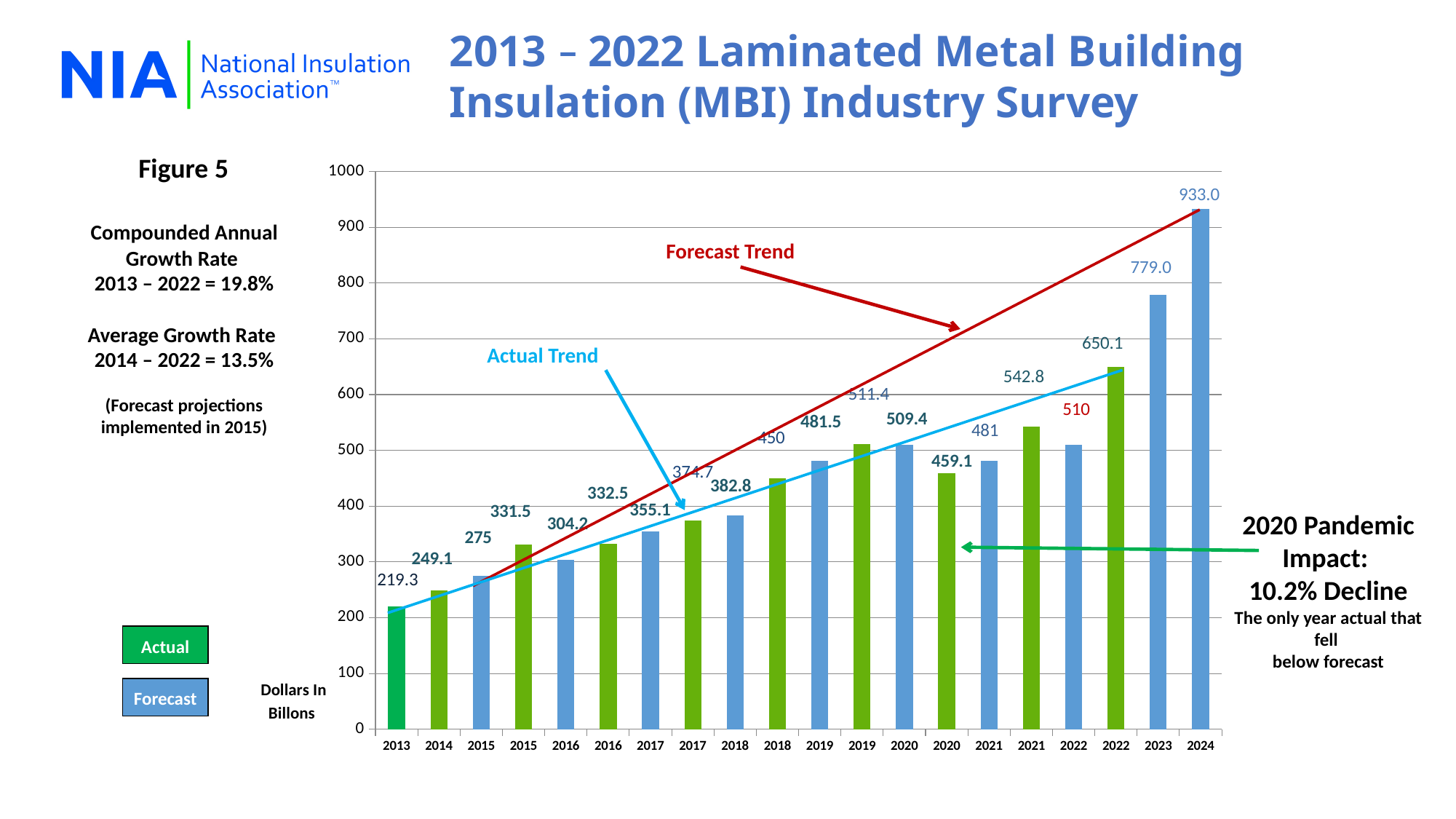
How many bars are plotted on the chart? 20 What kind of chart is shown on the slide? Bar chart How many series does the legend list? 2 For 2022, which is larger: the actual value or the forecast value? Actual (650.1) What is the actual value for 2020? 459.1 Which bar has the lowest value on the chart? 2013 actual (219.3) What is the actual value for 2013? 219.3 What is the forecast value for 2024? 933.0 What is the difference between the 2022 actual value and the 2021 actual value? 107.3 Do the actual values rise or fall from 2013 to 2019? Rise What is the difference between the 2020 forecast value and the 2020 actual value? 50.3 Which bar has the highest value on the chart? 2024 forecast (933.0)